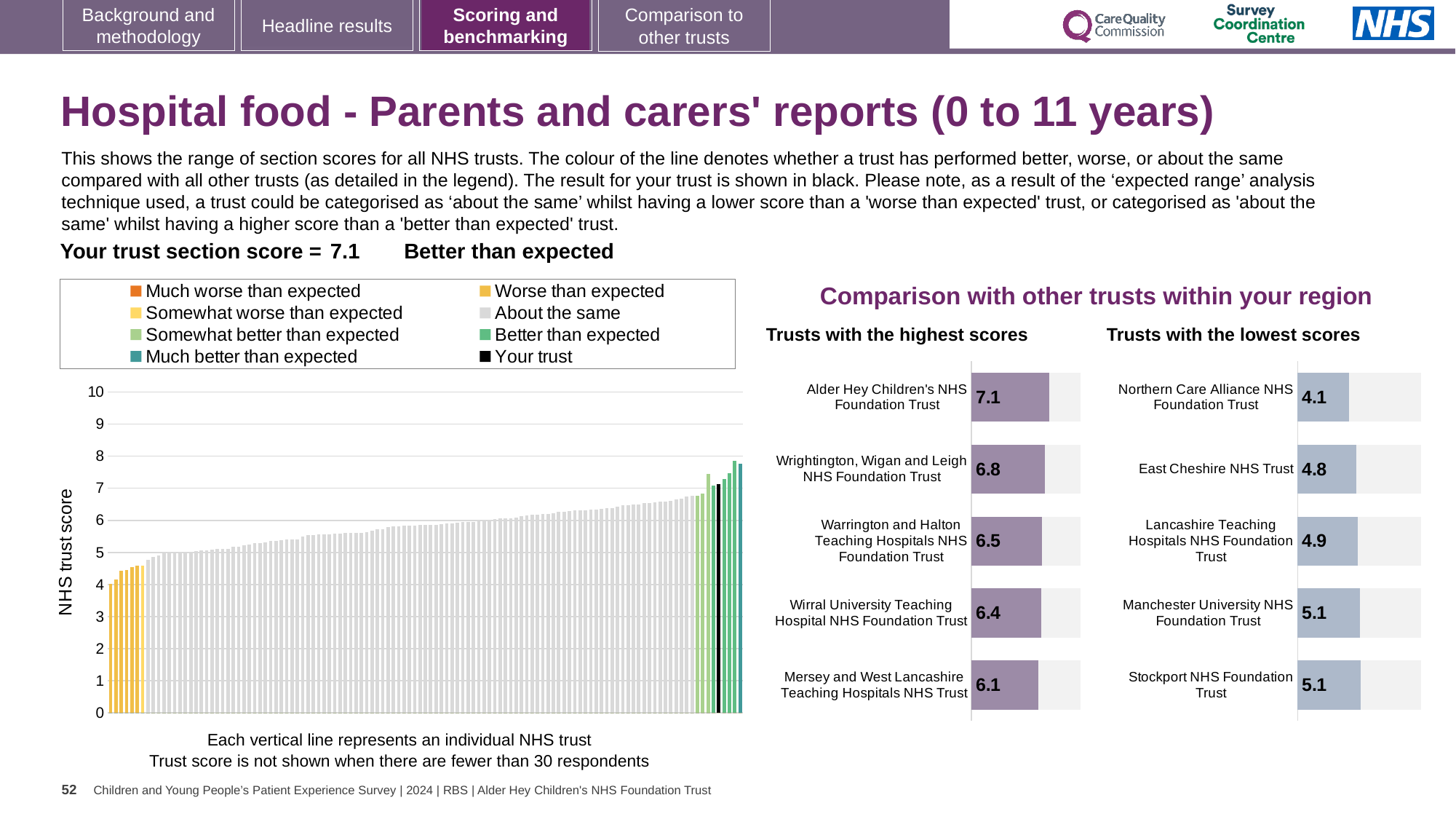
In the 'Trusts with the lowest scores' chart, which has the larger score: Lancashire Teaching Hospitals NHS Foundation Trust or East Cheshire NHS Trust? Lancashire Teaching Hospitals NHS Foundation Trust In the 'Trusts with the lowest scores' chart, which trust has the lowest score? Northern Care Alliance NHS Foundation Trust In the 'NHS trust score' chart on the left, do the bars rise or fall from left to right? Rise In the 'Trusts with the highest scores' chart, which trust has the highest score? Alder Hey Children's NHS Foundation Trust In the 'Trusts with the highest scores' chart, what is the difference between the scores of Alder Hey Children's NHS Foundation Trust and Mersey and West Lancashire Teaching Hospitals NHS Trust? 1.0 What kind of chart is the 'NHS trust score' chart on the left of the slide? Bar chart In the 'Trusts with the lowest scores' chart, what is the score for East Cheshire NHS Trust? 4.8 In the 'Trusts with the highest scores' chart, what is the score for Wrightington, Wigan and Leigh NHS Foundation Trust? 6.8 How many trusts are shown in the 'Trusts with the highest scores' chart? 5 In the 'NHS trust score' chart on the left, what colour is the bar for 'Your trust' according to the legend? Black How many entries does the legend of the 'NHS trust score' chart on the left list? 8 In the 'Trusts with the lowest scores' chart, what is the difference between the scores of East Cheshire NHS Trust and Northern Care Alliance NHS Foundation Trust? 0.7